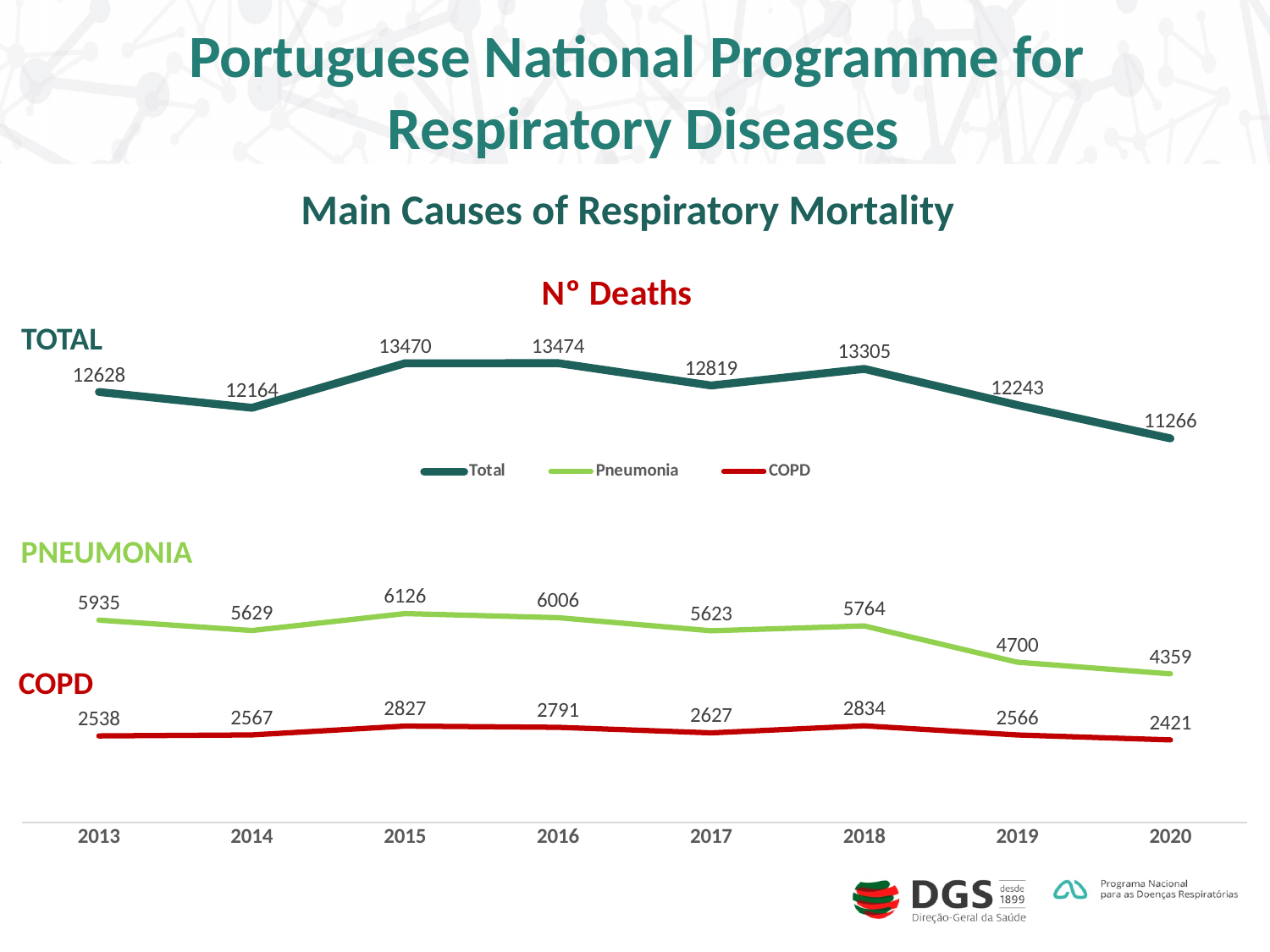
What is the Pneumonia value for 2019? 4700 How many years are shown on the x axis? 8 In which year is the Total number of deaths lowest? 2020 What kind of chart is shown on the slide? Line chart How many series does the legend list? 3 What is the Total number of deaths in 2016? 13474 Which is larger, the COPD value in 2015 or in 2018? 2018 What is the COPD value for 2018? 2834 In which year is the Pneumonia value highest? 2015 What is the difference between the Total values for 2013 and 2020? 1362 What is the title of the chart? N° Deaths Does the Pneumonia series rise or fall from 2018 to 2020? Fall